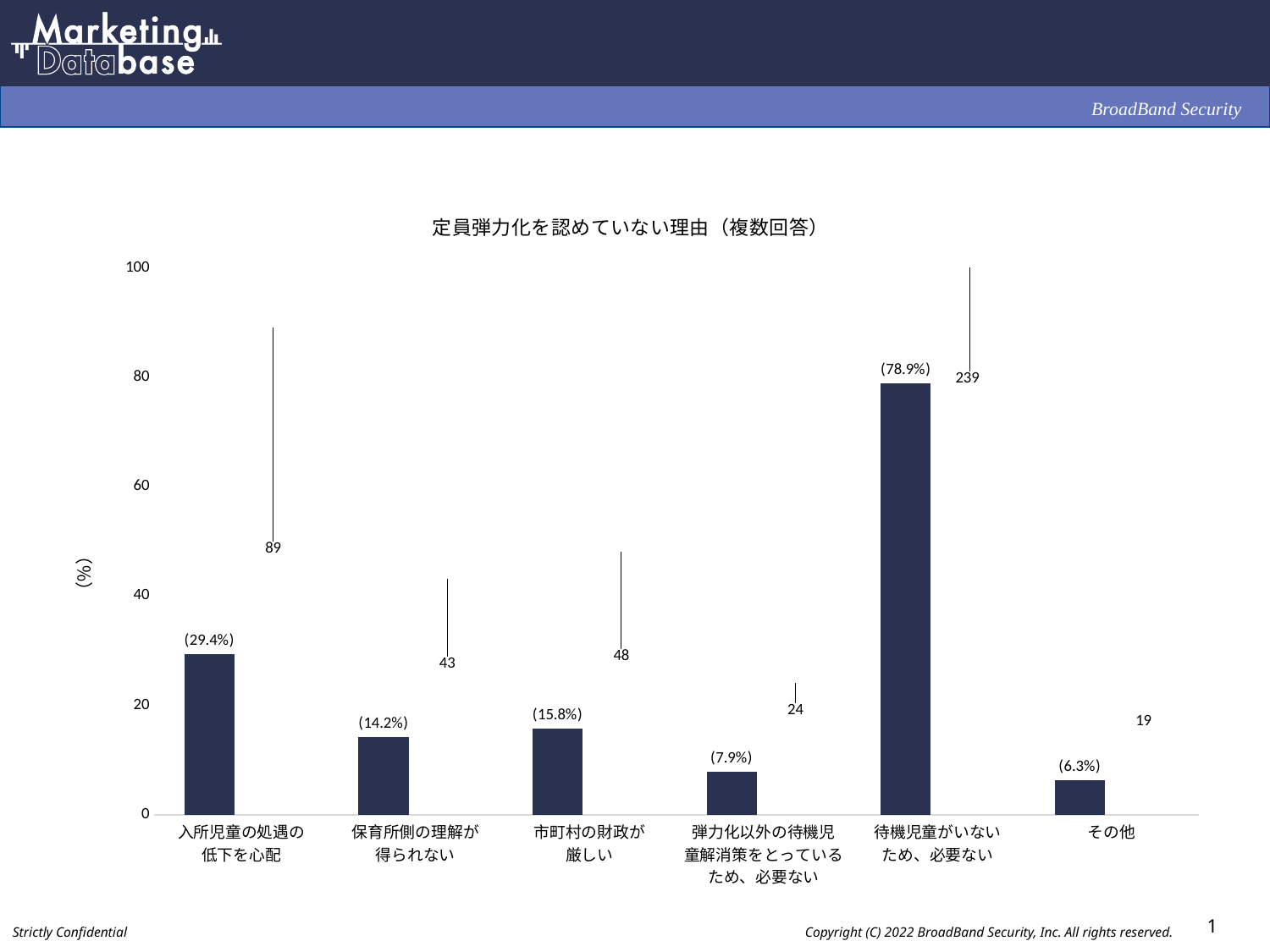
What is the difference in percentage points between 入所児童の処遇の低下を心配 and 保育所側の理解が得られない? 15.2 What is the title of the chart? 定員弾力化を認めていない理由（複数回答） What percentage is shown for 市町村の財政が厳しい? 15.8% What percentage is shown for その他? 6.3% What number is printed above the bar for 待機児童がいないため、必要ない, next to the percentage label? 239 What percentage is shown for 入所児童の処遇の低下を心配? 29.4% Which category has the highest percentage? 待機児童がいないため、必要ない Which category has the lowest percentage? その他 How many categories are shown on the x axis of the chart? 6 What percentage is shown for 待機児童がいないため、必要ない? 78.9% What kind of chart is shown on the slide? bar chart Which has a higher percentage, 市町村の財政が厳しい or 弾力化以外の待機児童解消策をとっているため、必要ない? 市町村の財政が厳しい